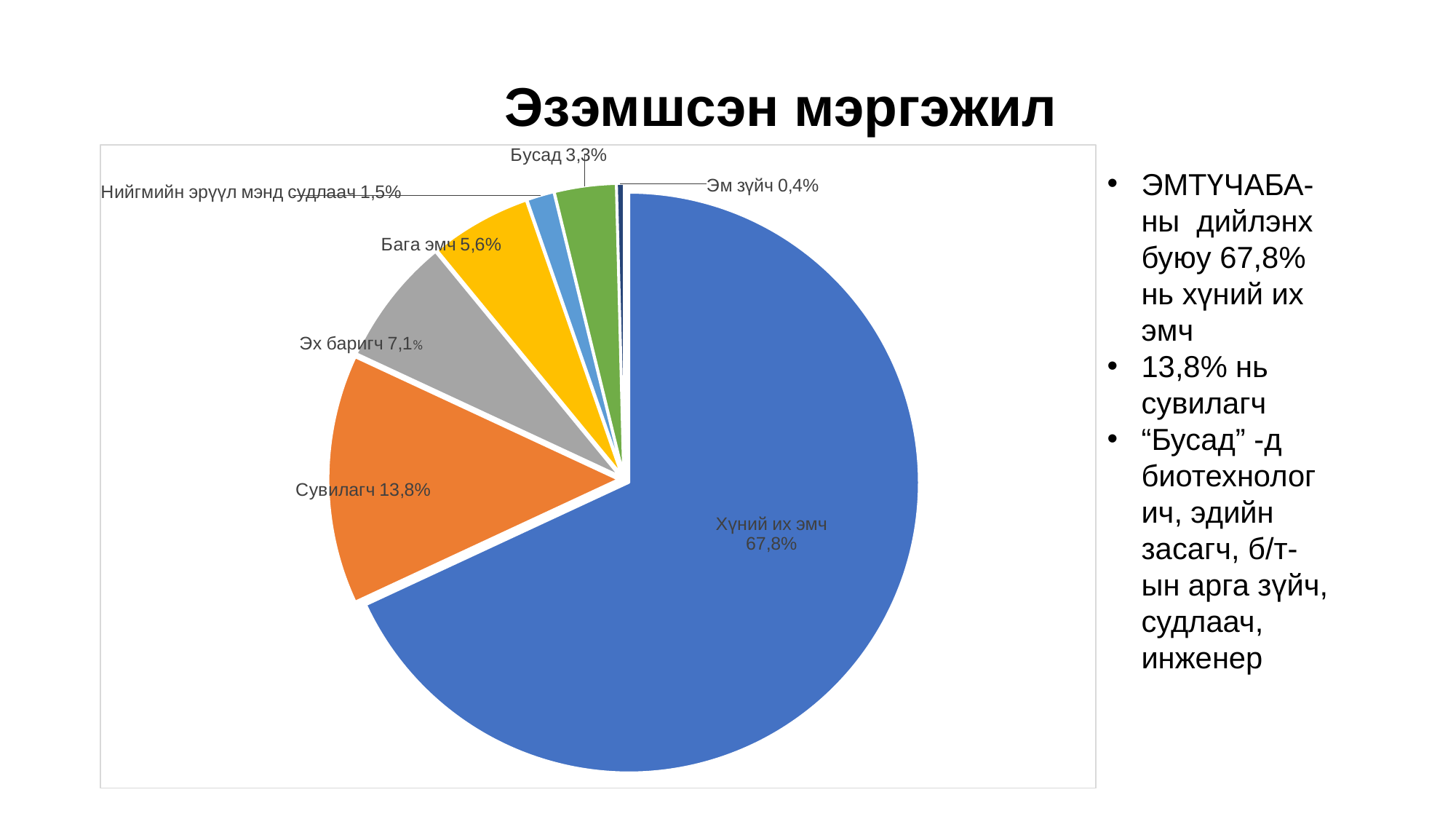
What is the share for Бага эмч? 5,6% What kind of chart is shown on the slide? Pie chart What is the share for Эх баригч? 7,1% What is the difference in percentage points between Сувилагч and Эх баригч? 6,7 What is the share for Хүний их эмч? 67,8% Which category has the smallest slice of the pie? Эм зүйч Which category has the largest slice of the pie? Хүний их эмч What is the title of the chart? Эзэмшсэн мэргэжил What is the share for Эм зүйч? 0,4% How many slices does the pie chart have? 7 What is the share for Нийгмийн эрүүл мэнд судлаач? 1,5% What is the share for Сувилагч? 13,8%